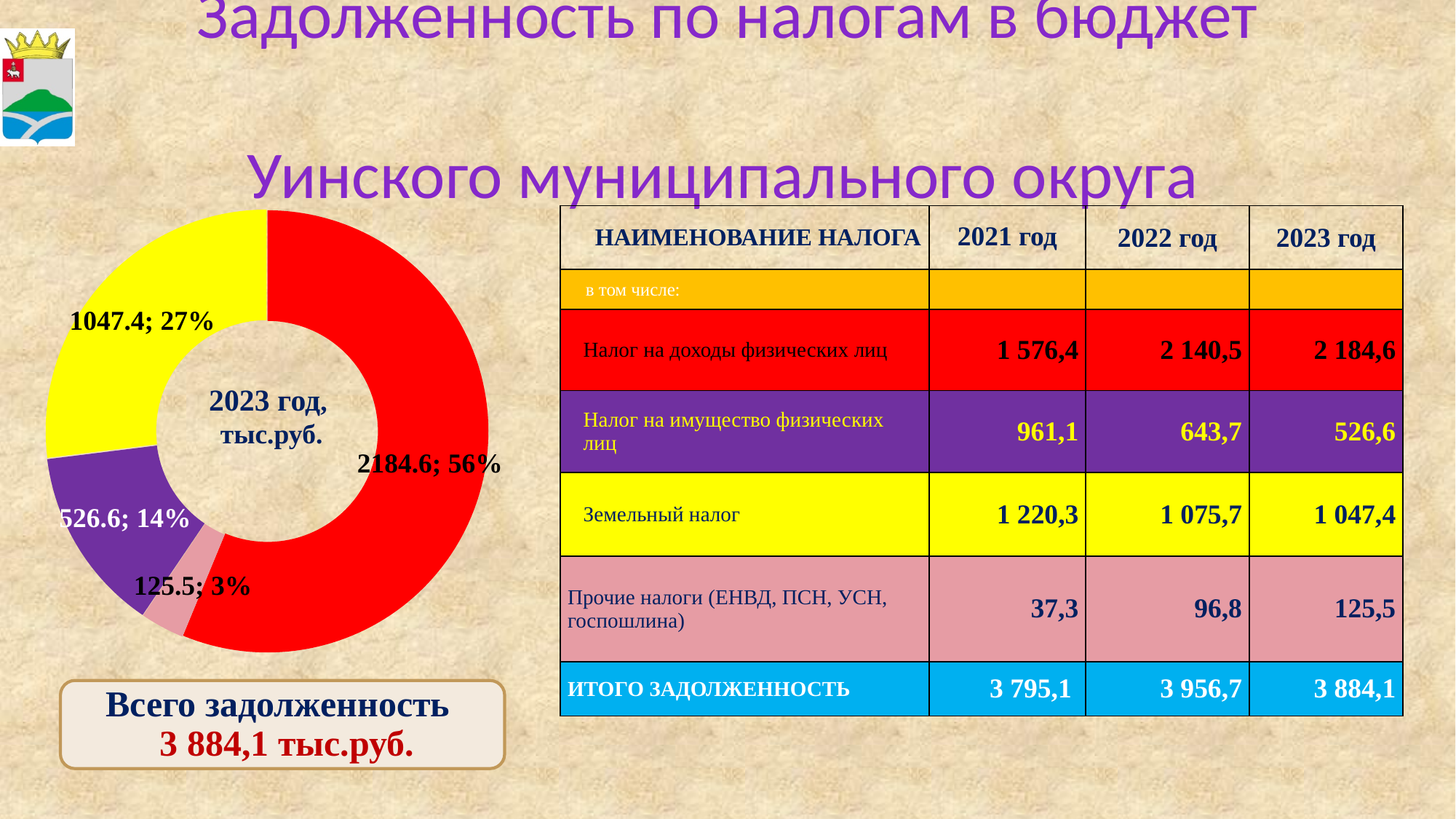
Which slice of the doughnut chart is the smallest? The pink slice (125.5; 3%) What value is shown for the purple slice of the doughnut chart? 526.6 What percentage share does the pink slice of the doughnut chart have? 3% What text is shown in the centre of the doughnut chart? 2023 год, тыс.руб. What percentage share does the yellow slice of the doughnut chart have? 27% Which is larger in the doughnut chart, the purple slice or the yellow slice? The yellow slice How many slices does the doughnut chart have? 4 What is the total of all four slice values in the doughnut chart? 3884.1 Which slice of the doughnut chart is the largest? The red slice (2184.6; 56%) What value is shown for the red slice of the doughnut chart? 2184.6 What is the difference between the red slice value and the yellow slice value in the doughnut chart? 1137.2 What kind of chart is shown on the left of the slide? Doughnut (pie) chart